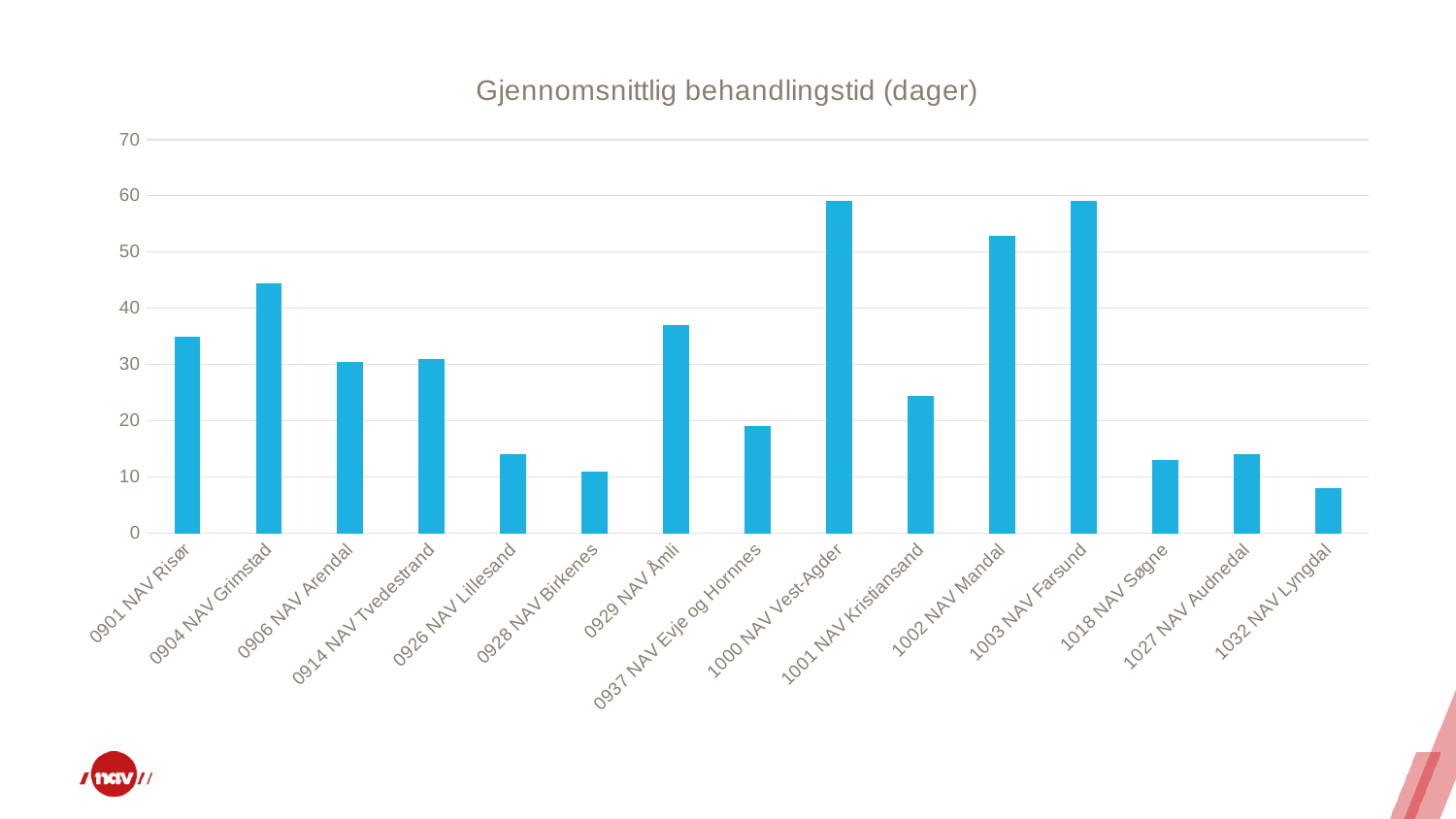
Which is larger, the value for 1002 NAV Mandal or the value for 1001 NAV Kristiansand? 1002 NAV Mandal What is the highest value shown on the y axis? 70 Which is larger, the value for 0929 NAV Åmli or the value for 0937 NAV Evje og Hornnes? 0929 NAV Åmli Is the value for 1003 NAV Farsund greater or less than 50? greater Is the value for 0904 NAV Grimstad greater or less than 40? greater Is the value for 1000 NAV Vest-Agder greater or less than 50? greater What kind of chart is shown on the slide? bar chart Which category has the lowest value? 1032 NAV Lyngdal How many categories (NAV offices) are shown on the x axis? 15 What is the title of the chart? Gjennomsnittlig behandlingstid (dager)